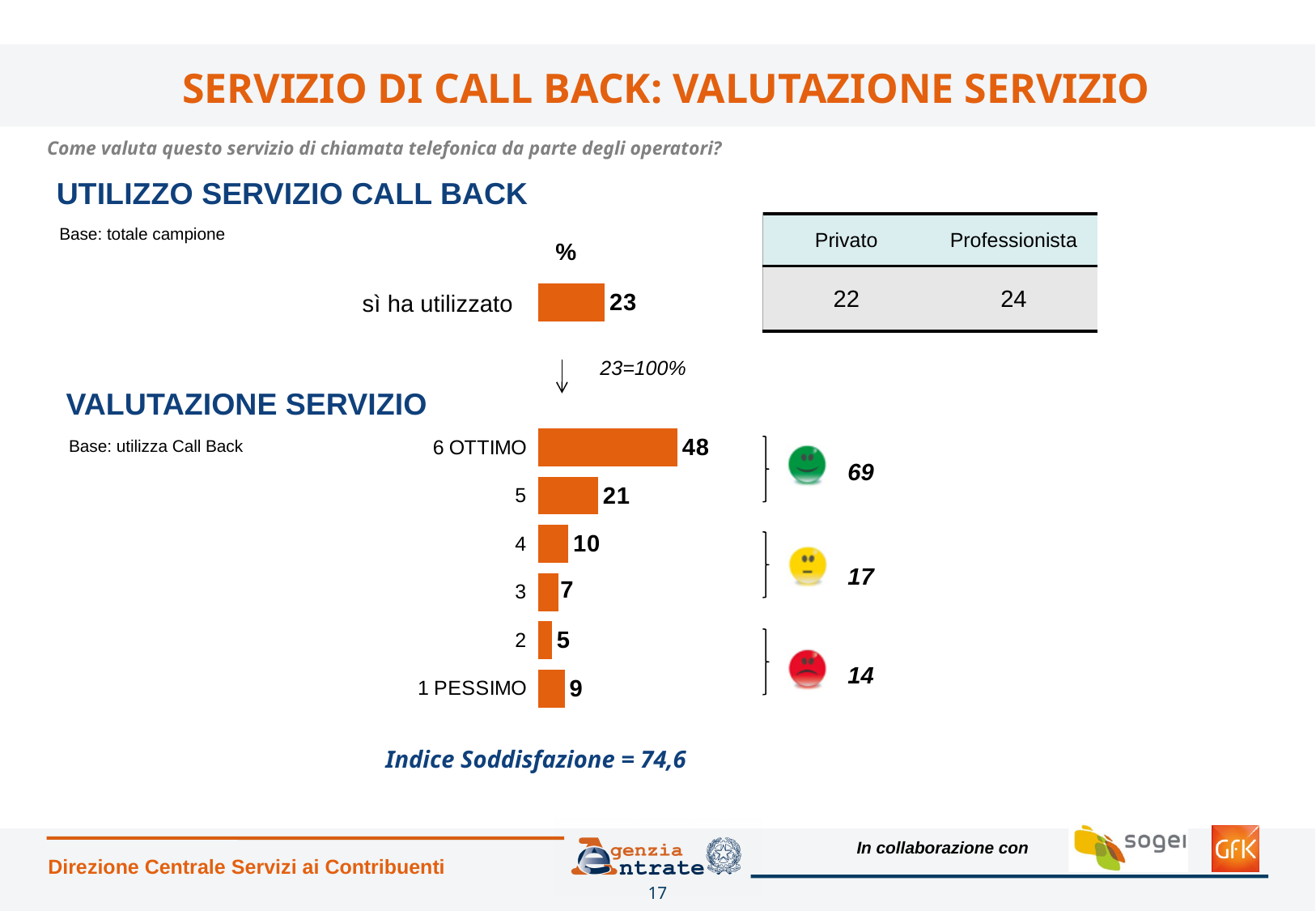
In the VALUTAZIONE SERVIZIO chart, what is the total of the values for categories 6 OTTIMO and 5 (the green smiley group)? 69 In the VALUTAZIONE SERVIZIO chart, what is the value for category 4? 10 In the VALUTAZIONE SERVIZIO chart, which is larger, the value for category 3 or the value for 1 PESSIMO? 1 PESSIMO How many categories are shown in the VALUTAZIONE SERVIZIO chart? 6 In the VALUTAZIONE SERVIZIO chart, what is the value for the category 1 PESSIMO? 9 What kind of chart is the VALUTAZIONE SERVIZIO chart? Bar chart In the VALUTAZIONE SERVIZIO chart, which category has the highest value? 6 OTTIMO In the UTILIZZO SERVIZIO CALL BACK chart, what is the value for 'sì ha utilizzato'? 23 In the VALUTAZIONE SERVIZIO chart, what is the value for the category 6 OTTIMO? 48 In the VALUTAZIONE SERVIZIO chart, what is the difference between the values for 6 OTTIMO and 5? 27 What is the Indice Soddisfazione shown below the VALUTAZIONE SERVIZIO chart? 74,6 In the VALUTAZIONE SERVIZIO chart, which category has the lowest value? 2